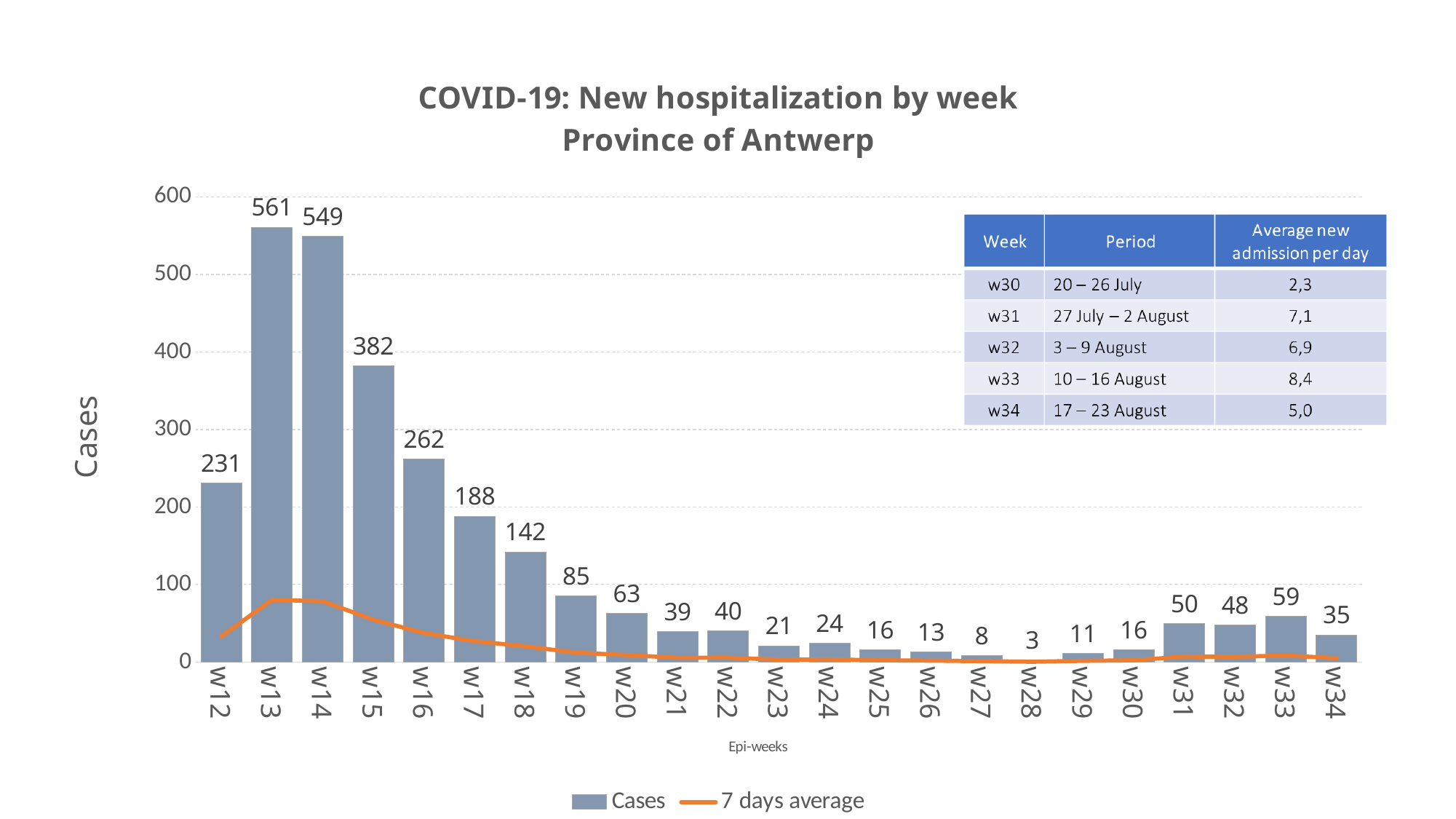
Which week has the lowest number of cases? w28 How many weeks are shown on the x axis? 23 Which week has the highest number of cases? w13 What kind of chart is used to show the Cases series? bar chart How many series does the legend list? 2 Do the cases generally rise or fall from w13 to w28? fall What is the title of the chart? COVID-19: New hospitalization by week Province of Antwerp What is the difference in cases between w13 and w14? 12 What is the number of cases for w13? 561 What is the number of cases for w34? 35 What is the number of cases for w18? 142 Which week has more cases, w31 or w33? w33